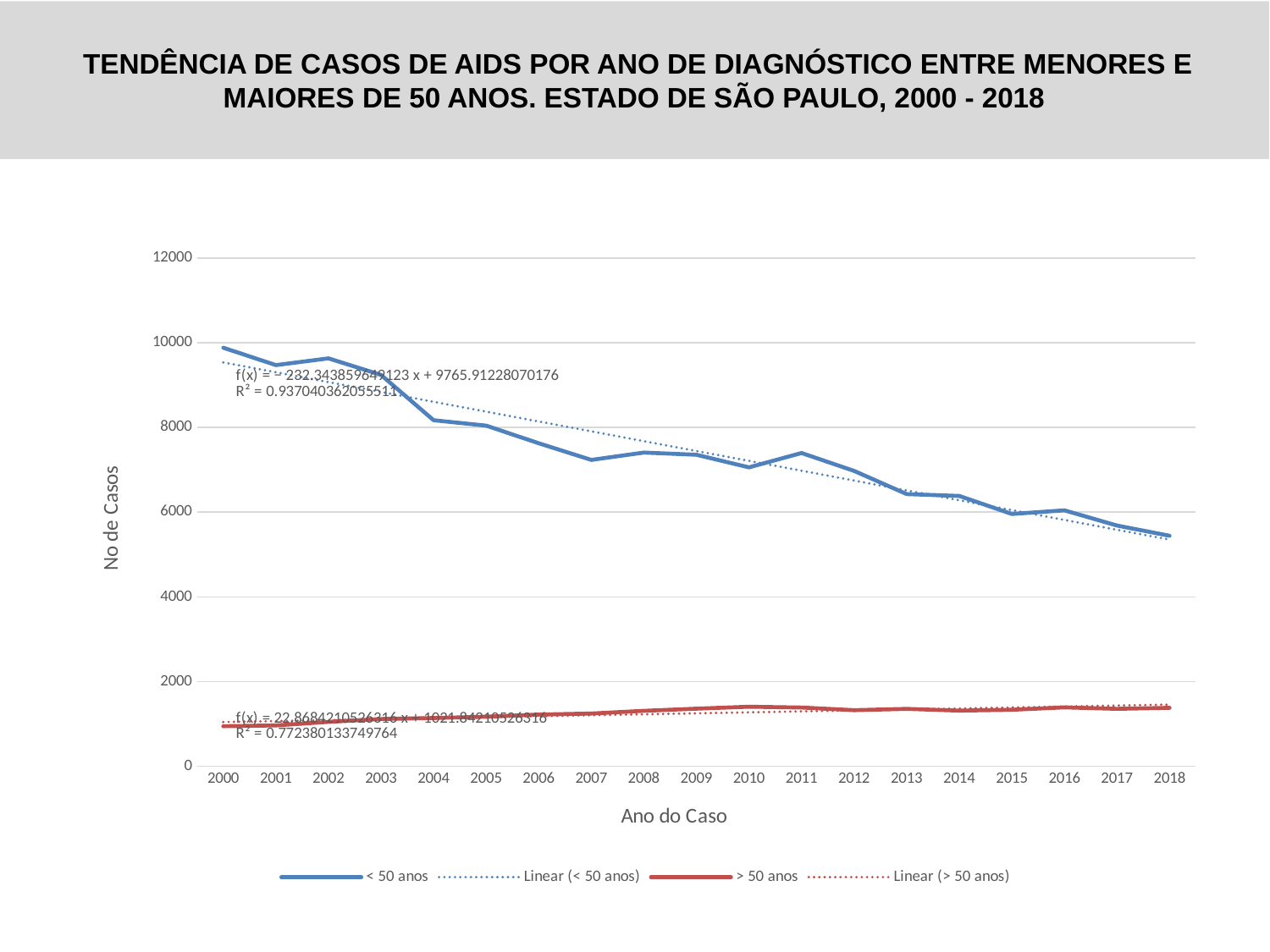
What kind of chart is shown on the slide? line chart How many series does the legend list? 4 In which year is the '< 50 anos' series highest? 2000 Which series has the larger value in 2010, '< 50 anos' or '> 50 anos'? < 50 anos How many years are plotted along the x axis? 19 Is the value for '> 50 anos' in 2018 greater or less than 2000? less Is the value for '< 50 anos' in 2000 greater or less than 8000? greater Do the values for the '> 50 anos' series rise or fall from 2000 to 2018? rise Is the value for '< 50 anos' in 2018 greater or less than 6000? less In which year is the '< 50 anos' series lowest? 2018 What is the title of the y axis? No de Casos Do the values for the '< 50 anos' series rise or fall from 2000 to 2018? fall